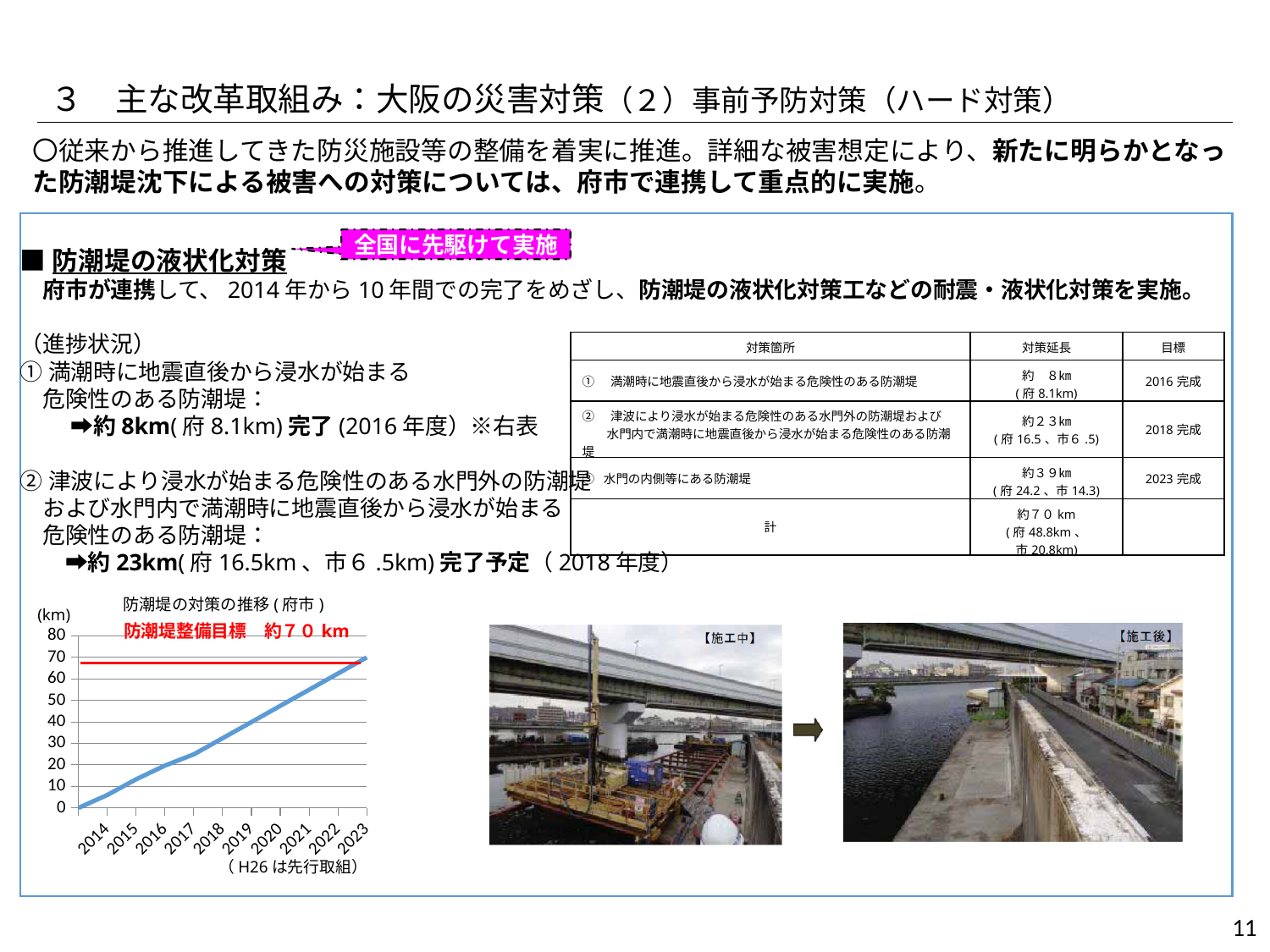
What target is labelled on the red horizontal line in the 防潮堤の対策の推移（府市） chart? 防潮堤整備目標 約70 km In the 防潮堤の対策の推移（府市） chart, which is larger, the value for 2022 or the value for 2016? 2022 In the 防潮堤の対策の推移（府市） chart, which year has the highest value? 2023 What unit is shown on the y axis of the 防潮堤の対策の推移（府市） chart? km In the 防潮堤の対策の推移（府市） chart, is the value for 2022 greater or less than 50? greater Does the blue line in the 防潮堤の対策の推移（府市） chart rise or fall from 2014 to 2023? rise What kind of chart is the chart titled 防潮堤の対策の推移（府市）? line chart In the 防潮堤の対策の推移（府市） chart, is the value for 2018 greater or less than 40? less How many years are plotted along the x axis of the 防潮堤の対策の推移（府市） chart? 10 In the 防潮堤の対策の推移（府市） chart, is the value for 2016 greater or less than 30? less In the 防潮堤の対策の推移（府市） chart, which year has the lowest value? 2014